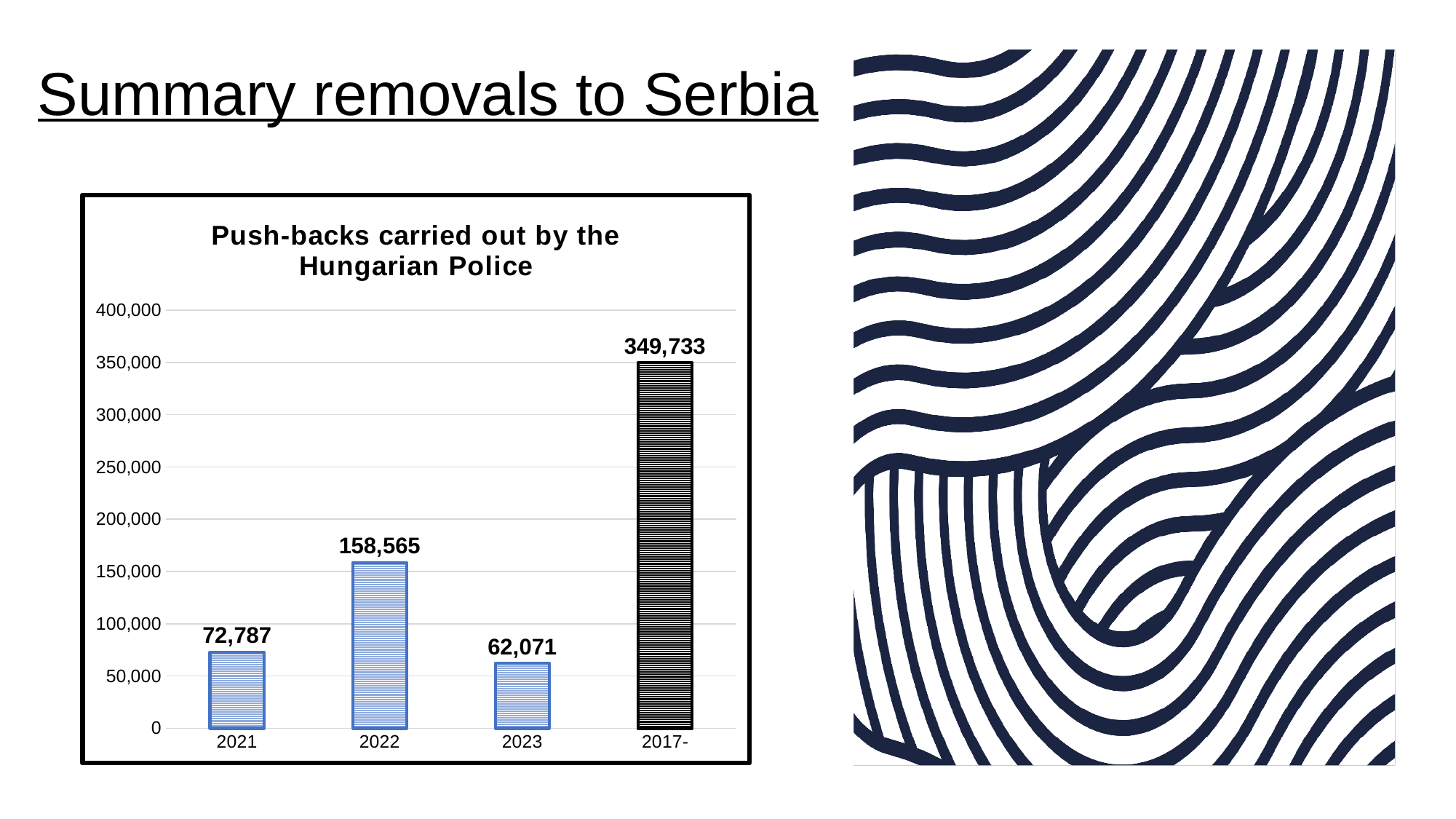
What is the value for the 2017- bar? 349,733 What is the difference between the values for 2022 and 2021? 85,778 Which is larger, the value for 2021 or the value for 2023? 2021 What is the title of the chart? Push-backs carried out by the Hungarian Police What is the value for 2023? 62,071 Is the value for 2022 greater or less than 150,000? greater What kind of chart is shown on the slide? Bar chart Which category has the highest value? 2017- What is the value for 2021? 72,787 What is the value for 2022? 158,565 How many bars are shown in the chart? 4 Which category has the lowest value? 2023